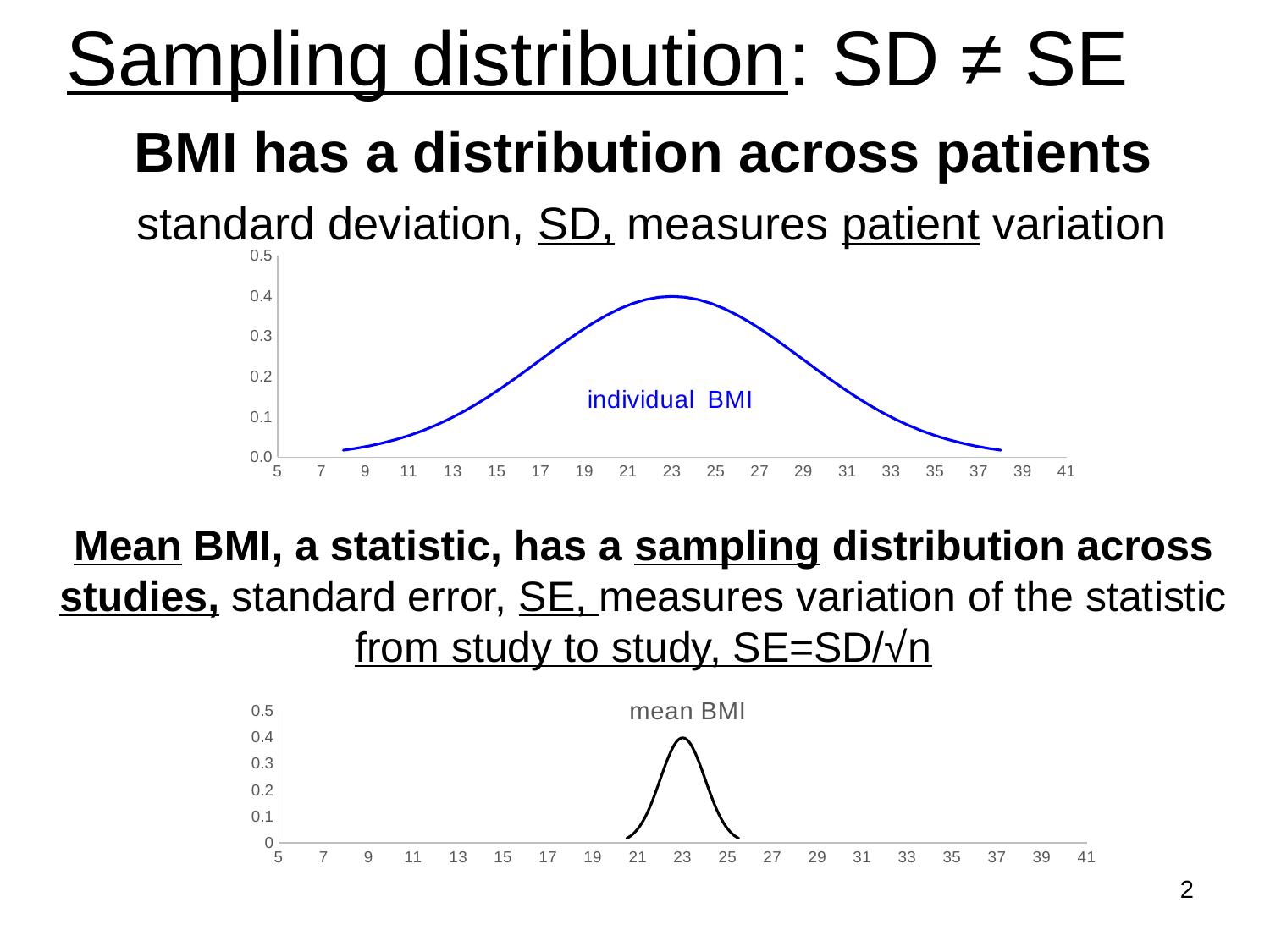
In the bottom chart (mean BMI), do the values rise or fall as x increases from 23 to 25? fall In the top chart (individual BMI), is the peak value of the curve greater or less than 0.3? greater What is the text label shown on the bottom chart's curve? mean BMI In the top chart (individual BMI), is the peak value of the curve greater or less than 0.5? less In the bottom chart (mean BMI), is the peak value of the curve greater or less than 0.3? greater In the top chart (individual BMI), at which x-axis value does the curve reach its highest point? 23 In the top chart (individual BMI), do the values rise or fall as x increases from 9 to 23? rise What colour is the curve in the top chart labelled "individual BMI"? blue What kind of chart is the bottom chart labelled "mean BMI"? line chart What kind of chart is the top chart labelled "individual BMI"? line chart